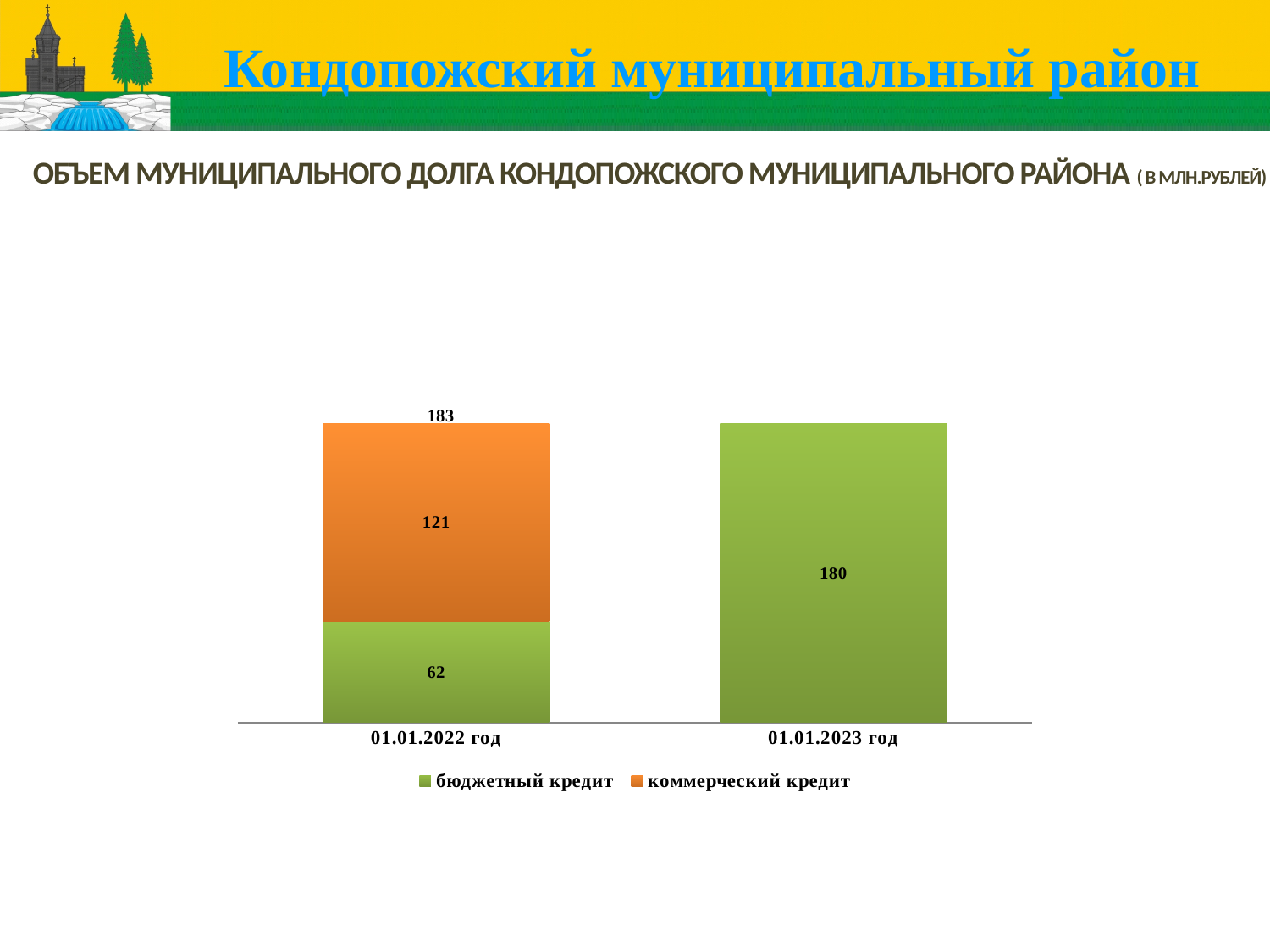
How many categories are shown on the x axis? 2 What is the value of бюджетный кредит for 01.01.2023 год? 180 By how much did бюджетный кредит change from 01.01.2022 год to 01.01.2023 год? 118 Does бюджетный кредит rise or fall from 01.01.2022 год to 01.01.2023 год? rise What is the difference between коммерческий кредит and бюджетный кредит for 01.01.2022 год? 59 Which is larger for 01.01.2022 год: бюджетный кредит or коммерческий кредит? коммерческий кредит What type of chart is shown on the slide? stacked bar chart What is the value of бюджетный кредит for 01.01.2022 год? 62 Which colour represents коммерческий кредит in the chart? orange What is the value of коммерческий кредит for 01.01.2022 год? 121 How many series does the legend list? 2 What is the total of the stacked bar for 01.01.2022 год? 183